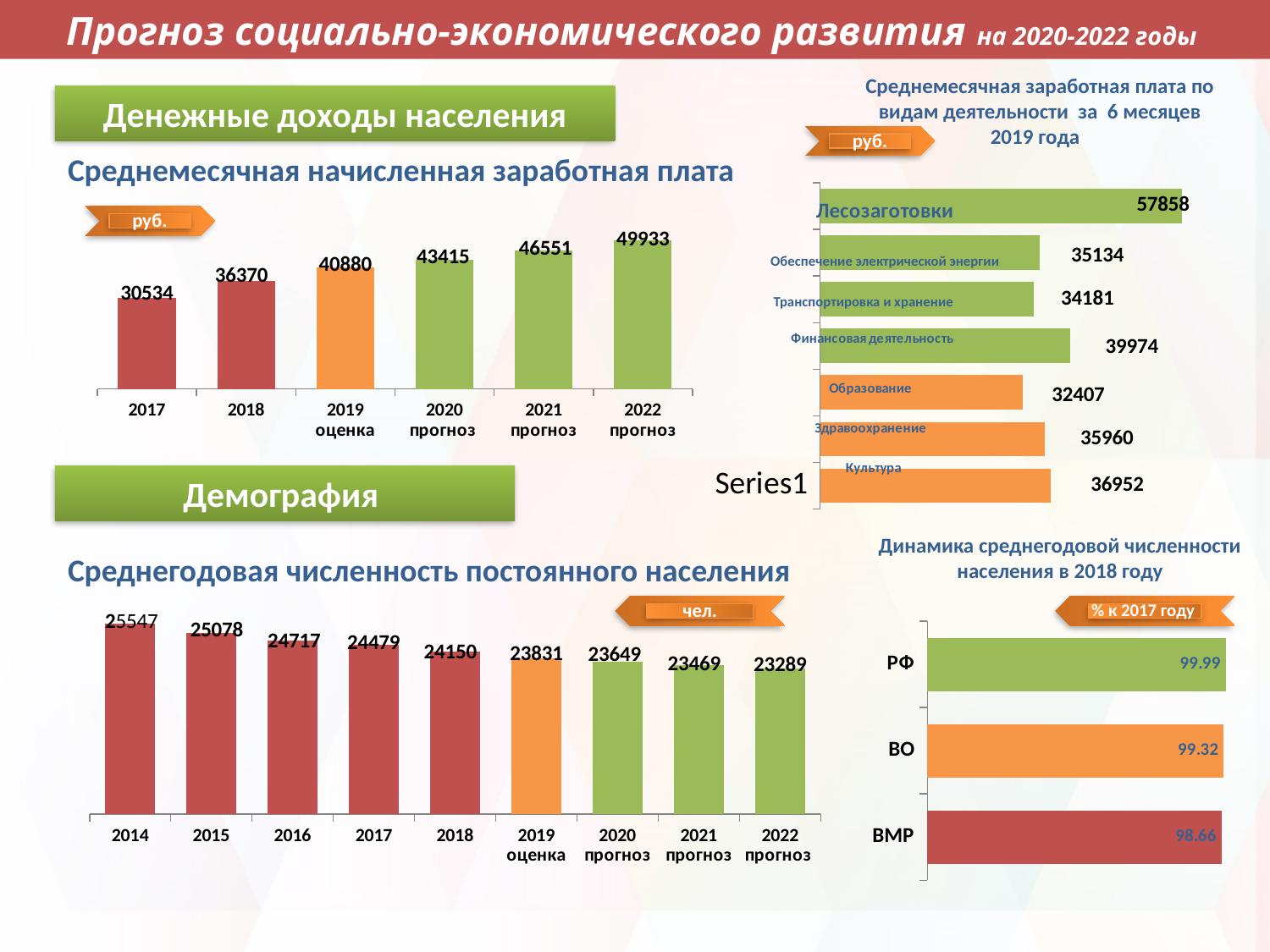
In the chart 'Среднемесячная заработная плата по видам деятельности за 6 месяцев 2019 года', how many categories are shown? 7 In the chart 'Среднемесячная начисленная заработная плата', do the values rise or fall from 2017 to 2022 прогноз? rise In the chart 'Среднегодовая численность постоянного населения', which year has the highest value? 2014 In the chart 'Динамика среднегодовой численности населения в 2018 году', which is larger, the value for ВО or the value for ВМР? ВО In the chart 'Среднегодовая численность постоянного населения', what is the value for 2018? 24150 In the chart 'Среднемесячная начисленная заработная плата', what is the value for 2019 оценка? 40880 In the chart 'Среднегодовая численность постоянного населения', how many years are shown on the x axis? 9 In the chart 'Среднемесячная заработная плата по видам деятельности за 6 месяцев 2019 года', what is the value for Финансовая деятельность? 39974 In the chart 'Среднемесячная заработная плата по видам деятельности за 6 месяцев 2019 года', which category has the lowest value? Образование What kind of chart is 'Динамика среднегодовой численности населения в 2018 году'? bar chart In the chart 'Среднемесячная заработная плата по видам деятельности за 6 месяцев 2019 года', which category has the highest value? Лесозаготовки In the chart 'Среднемесячная начисленная заработная плата', what is the difference between the 2022 прогноз value and the 2017 value? 19399